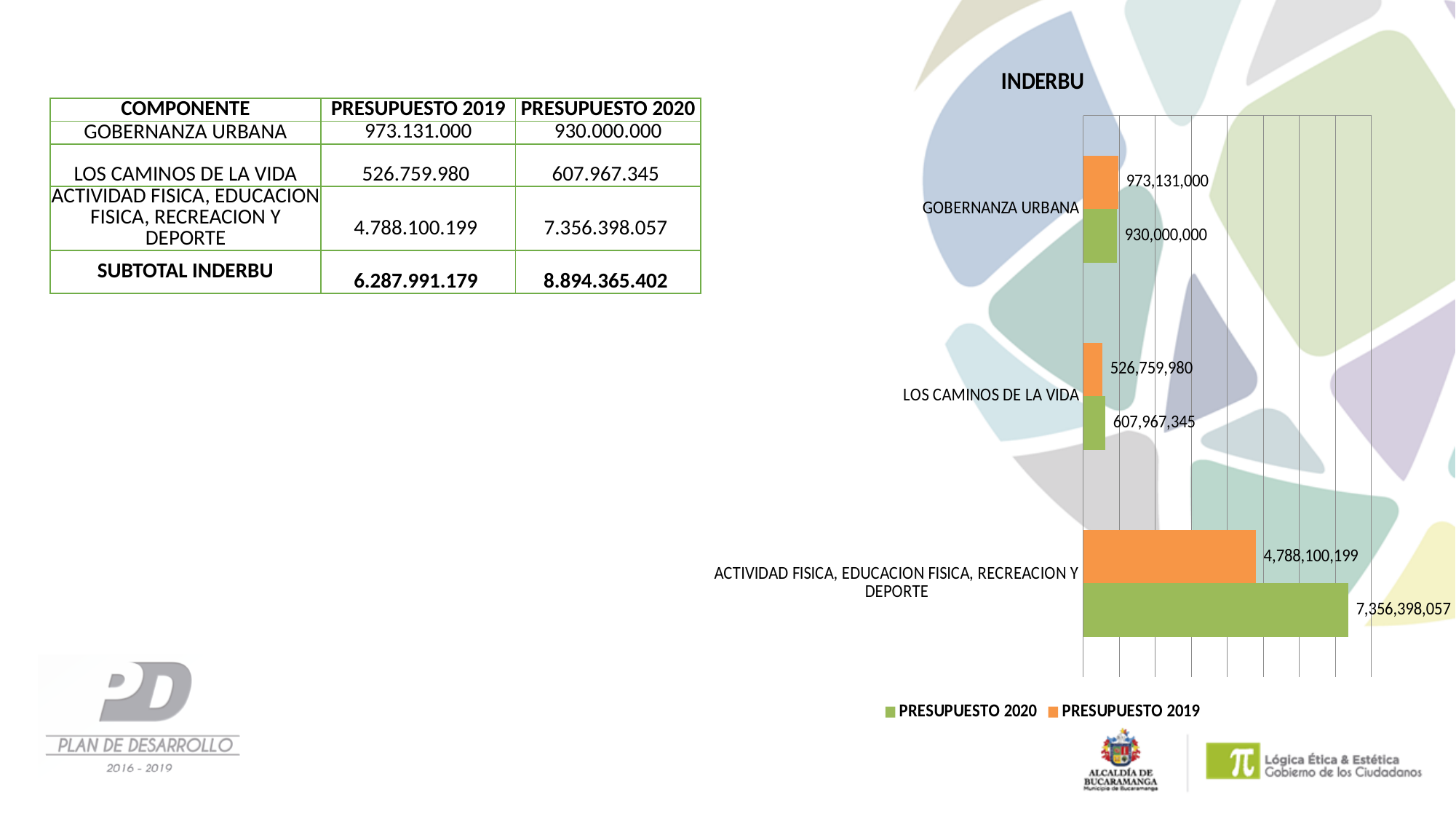
Which category has the highest PRESUPUESTO 2020 value? ACTIVIDAD FISICA, EDUCACION FISICA, RECREACION Y DEPORTE Which category has the lowest PRESUPUESTO 2019 value? LOS CAMINOS DE LA VIDA What is the PRESUPUESTO 2019 value for GOBERNANZA URBANA in the chart? 973,131,000 How many categories are shown on the chart? 3 Which colour represents PRESUPUESTO 2019 in the chart? orange What type of chart is shown on the slide? bar chart What is the PRESUPUESTO 2020 value for ACTIVIDAD FISICA, EDUCACION FISICA, RECREACION Y DEPORTE in the chart? 7,356,398,057 What is the PRESUPUESTO 2020 value for LOS CAMINOS DE LA VIDA in the chart? 607,967,345 What is the title of the chart? INDERBU For GOBERNANZA URBANA, which is larger: PRESUPUESTO 2019 or PRESUPUESTO 2020? PRESUPUESTO 2019 What is the difference between the PRESUPUESTO 2020 and PRESUPUESTO 2019 values for ACTIVIDAD FISICA, EDUCACION FISICA, RECREACION Y DEPORTE? 2,568,297,858 How many series does the chart legend list? 2